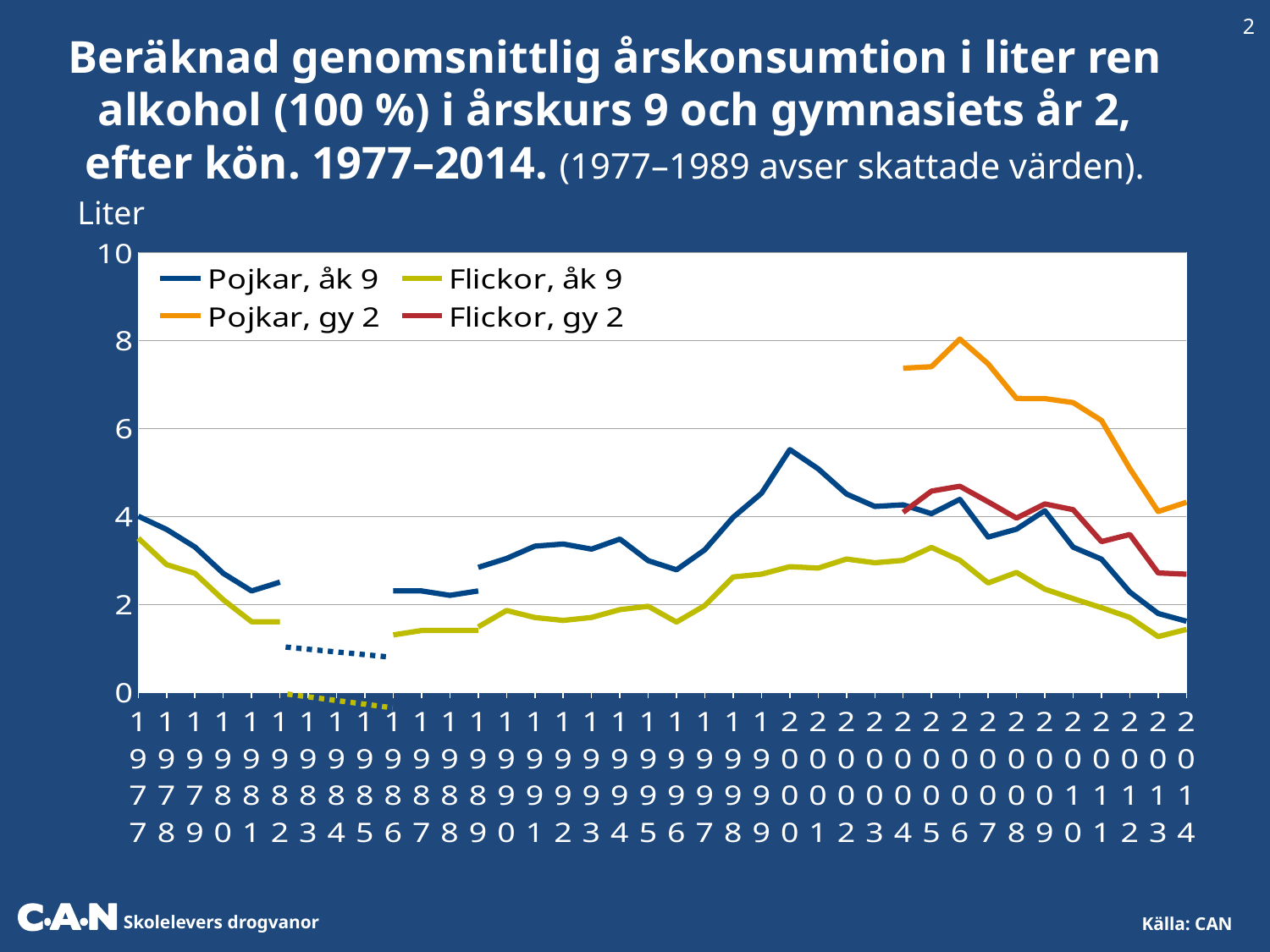
In which year does the Pojkar, åk 9 series reach its highest value? 2000 Is the value for Pojkar, åk 9 in 2000 greater or less than 4? greater Which series reaches the highest value anywhere on the chart? Pojkar, gy 2 How many series does the legend list? 4 Does the Pojkar, gy 2 series rise or fall between 2006 and 2013? fall What kind of chart is shown on the slide? line chart Is the value for Flickor, åk 9 in 2014 greater or less than 2? less In which year does the Pojkar, gy 2 series reach its peak? 2006 What is the label on the y axis of the chart? Liter How many years are shown on the x axis? 38 In 2010, which is larger: Pojkar, gy 2 or Flickor, gy 2? Pojkar, gy 2 Is the value for Pojkar, gy 2 in 2004 greater or less than 6? greater